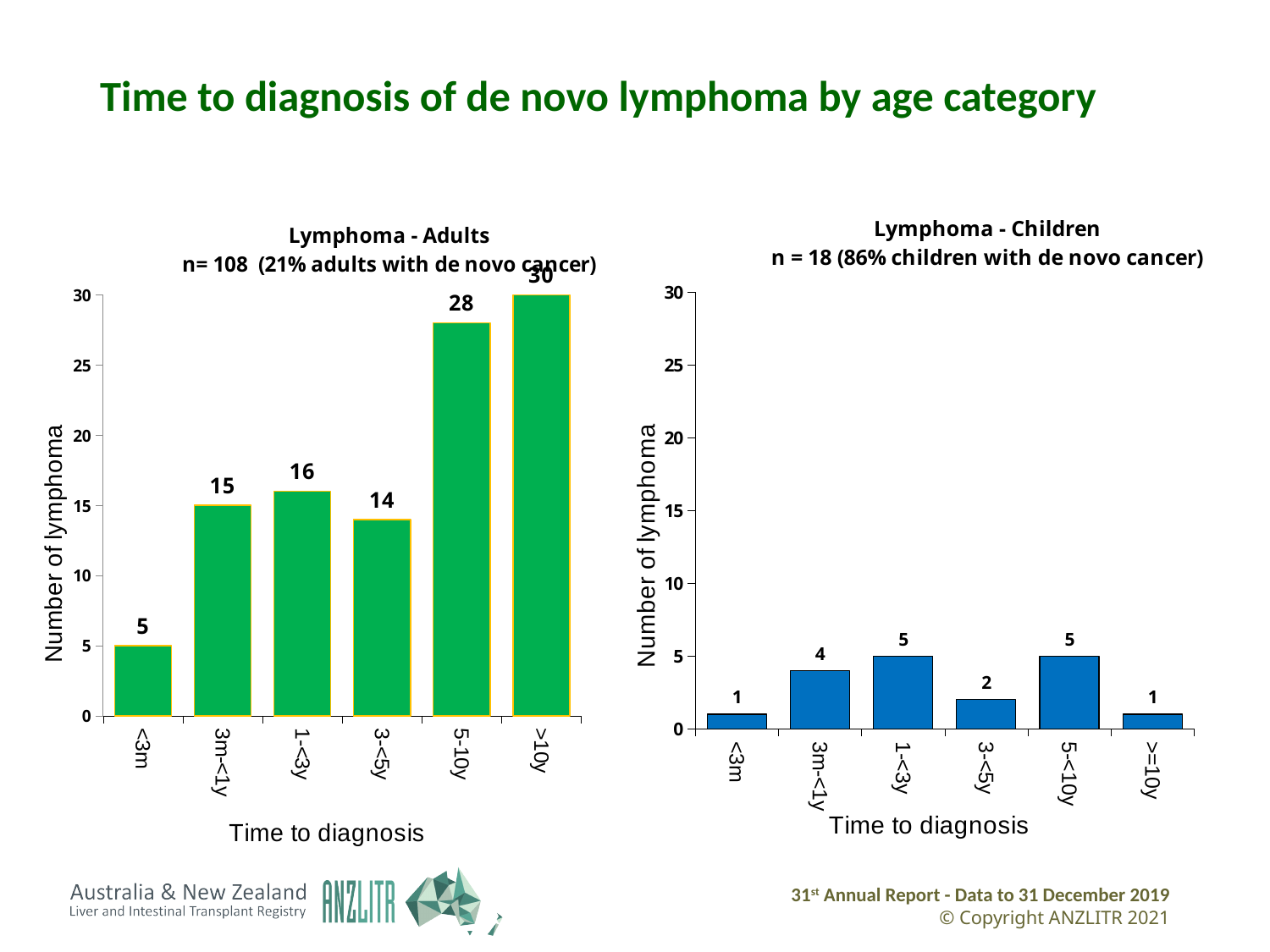
How many time to diagnosis categories are shown in the Lymphoma - Children chart? 6 In the Lymphoma - Children chart, what is the number of lymphoma for the 3-<5y category? 2 In the Lymphoma - Adults chart, which time to diagnosis category has the lowest number of lymphoma? <3m In the Lymphoma - Adults chart, is the value for 1-<3y greater or less than 20? less In the Lymphoma - Children chart, which is larger, the value for 1-<3y or the value for 3-<5y? 1-<3y In the Lymphoma - Adults chart, what is the difference between the 5-10y and 3-<5y values? 14 In the Lymphoma - Adults chart, what is the number of lymphoma for the 3m-<1y category? 15 In the Lymphoma - Adults chart, which time to diagnosis category has the highest number of lymphoma? >10y What kind of chart is the Lymphoma - Adults chart? Bar chart In the Lymphoma - Children chart, what is the number of lymphoma for the 3m-<1y category? 4 What colour are the bars in the Lymphoma - Children chart? Blue In the Lymphoma - Adults chart, what is the difference between the >10y value and the <3m value? 25